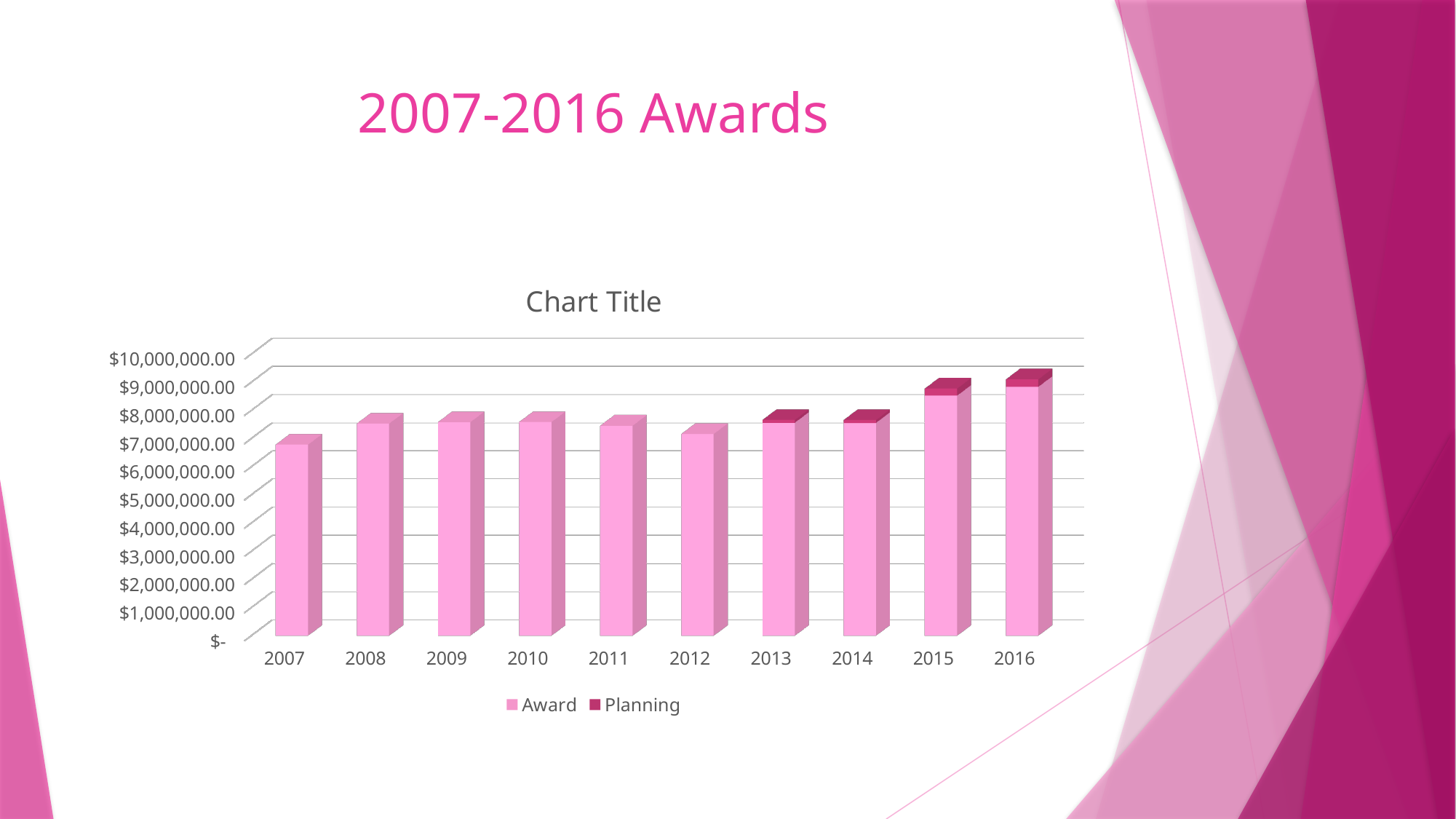
Which year has the shortest bar in the chart? 2007 Is the total bar for 2007 greater or less than $8,000,000.00? less Is the total bar for 2016 greater or less than $8,000,000.00? greater What is the title printed above the chart? Chart Title Which year has the tallest bar in the chart? 2016 Is the total bar for 2012 greater or less than $8,000,000.00? less How many series does the chart's legend list? 2 What kind of chart is shown on the slide? bar chart How many years are shown on the x axis of the chart? 10 What are the two series named in the chart's legend? Award and Planning Comparing 2007 with 2016, do the bar totals rise or fall? rise Which year has the larger total bar, 2015 or 2012? 2015